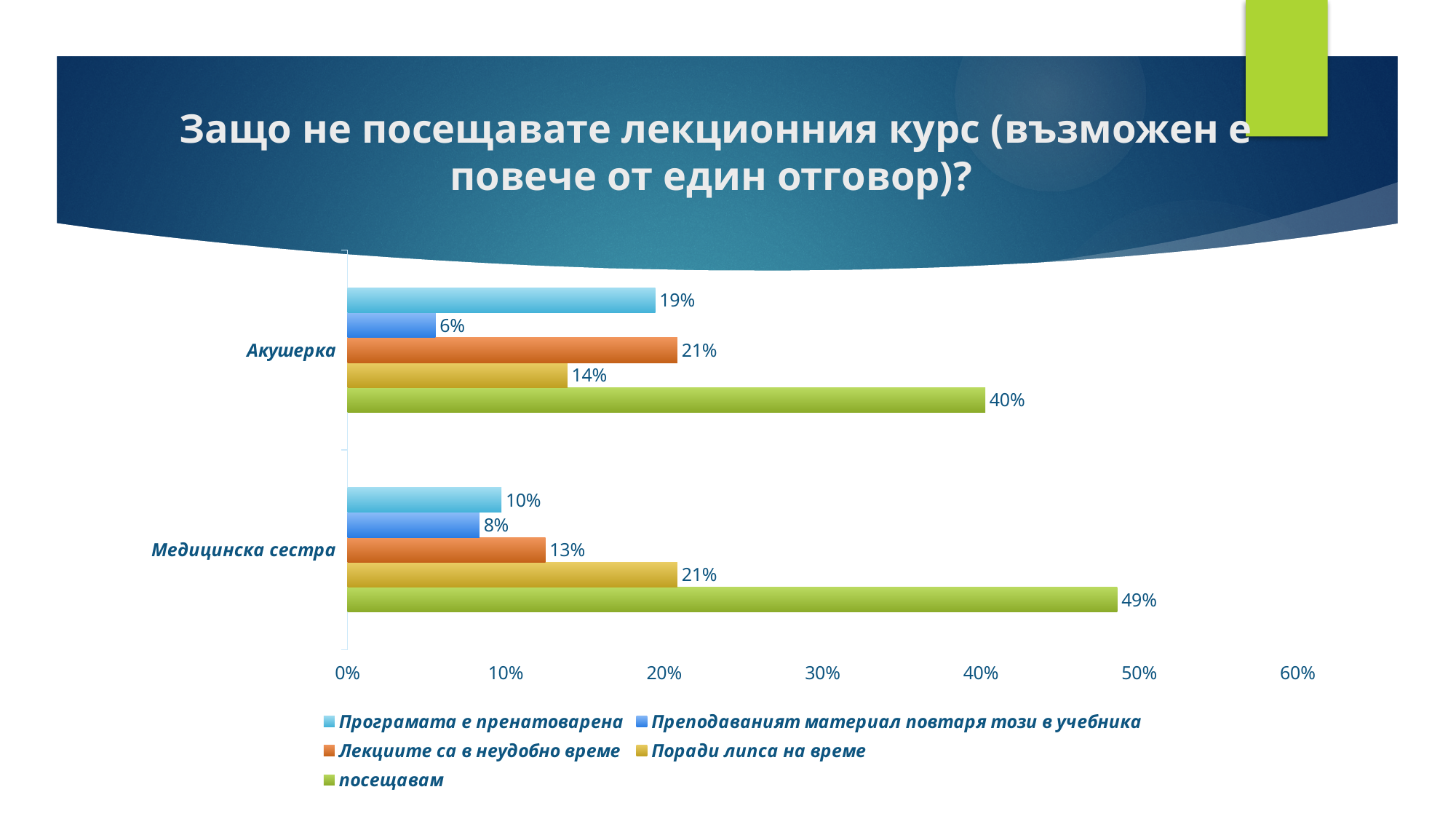
How many categories are shown on the vertical axis? 2 What kind of chart is shown on the slide? bar chart Which is larger: "Програмата е пренатоварена" for Акушерка or for Медицинска сестра? Акушерка What is the value of "Преподаваният материал повтаря този в учебника" for Акушерка? 6% What is the title of the chart on the slide? Защо не посещавате лекционния курс (възможен е повече от един отговор)? Which series has the highest value for Медицинска сестра? посещавам What is the difference between the "посещавам" values for Медицинска сестра and Акушерка? 9% What is the value of "Поради липса на време" for Медицинска сестра? 21% What is the value of "посещавам" for Акушерка? 40% How many series does the legend list? 5 Which series has the lowest value for Акушерка? Преподаваният материал повтаря този в учебника What is the value of "Лекциите са в неудобно време" for Медицинска сестра? 13%